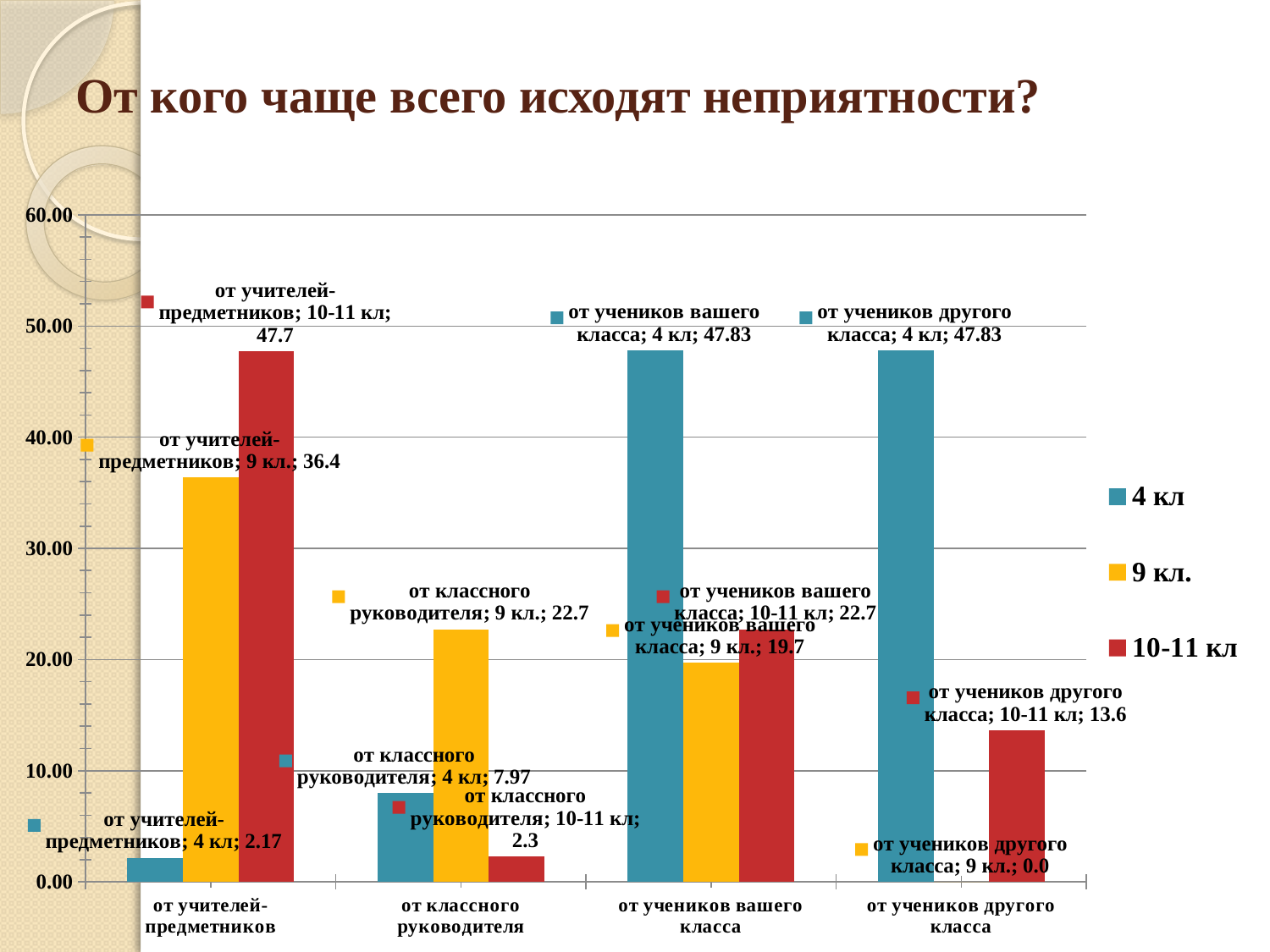
How many series does the legend list? 3 What is the value for 9 кл. in the category 'от классного руководителя'? 22.7 Which category has the highest value for the 9 кл. series? от учителей-предметников What is the value for 4 кл in the category 'от учеников вашего класса'? 47.83 What is the value for 10-11 кл in the category 'от учителей-предметников'? 47.7 What is the difference between the 10-11 кл value and the 9 кл. value in the category 'от учителей-предметников'? 11.3 How many categories are shown on the x axis? 4 What type of chart is shown on the slide? bar chart What is the title of the chart? От кого чаще всего исходят неприятности? Which category has the lowest value for the 4 кл series? от учителей-предметников What is the value for 9 кл. in the category 'от учеников другого класса'? 0.0 In the category 'от классного руководителя', which is larger: the value for 4 кл or the value for 10-11 кл? 4 кл